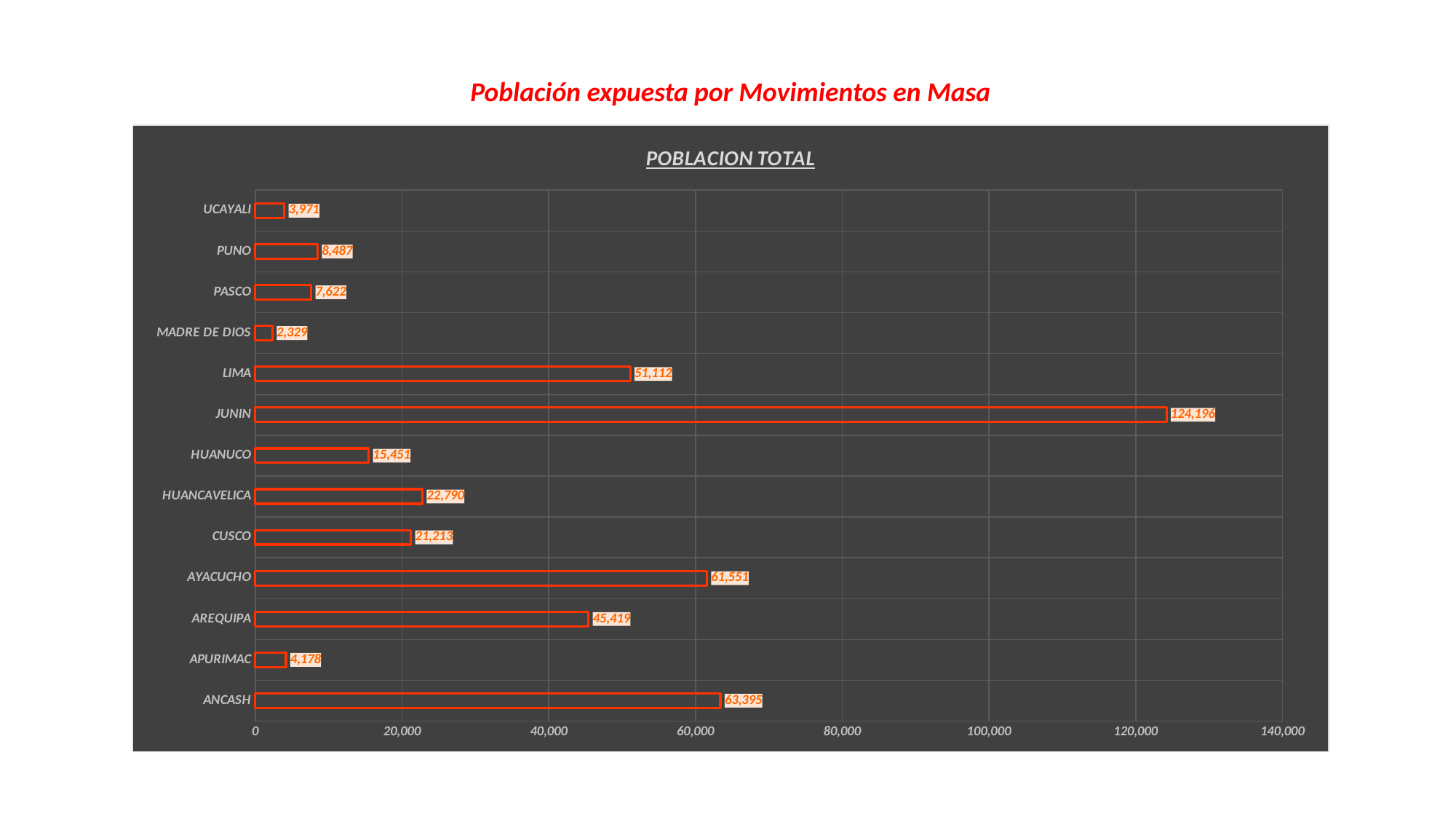
Which category has the lowest value? MADRE DE DIOS How many categories are shown on the chart? 13 What is the value for LIMA? 51,112 What is the difference between the values for JUNIN and LIMA? 73,084 Which is larger, the value for AREQUIPA or the value for LIMA? LIMA Which category has the highest value? JUNIN What kind of chart is shown on the slide? bar chart Is the value for AYACUCHO greater or less than 40,000? greater What is the value for MADRE DE DIOS? 2,329 What is the value for HUANCAVELICA? 22,790 What is the value for JUNIN? 124,196 What is the difference between the values for ANCASH and AYACUCHO? 1,844